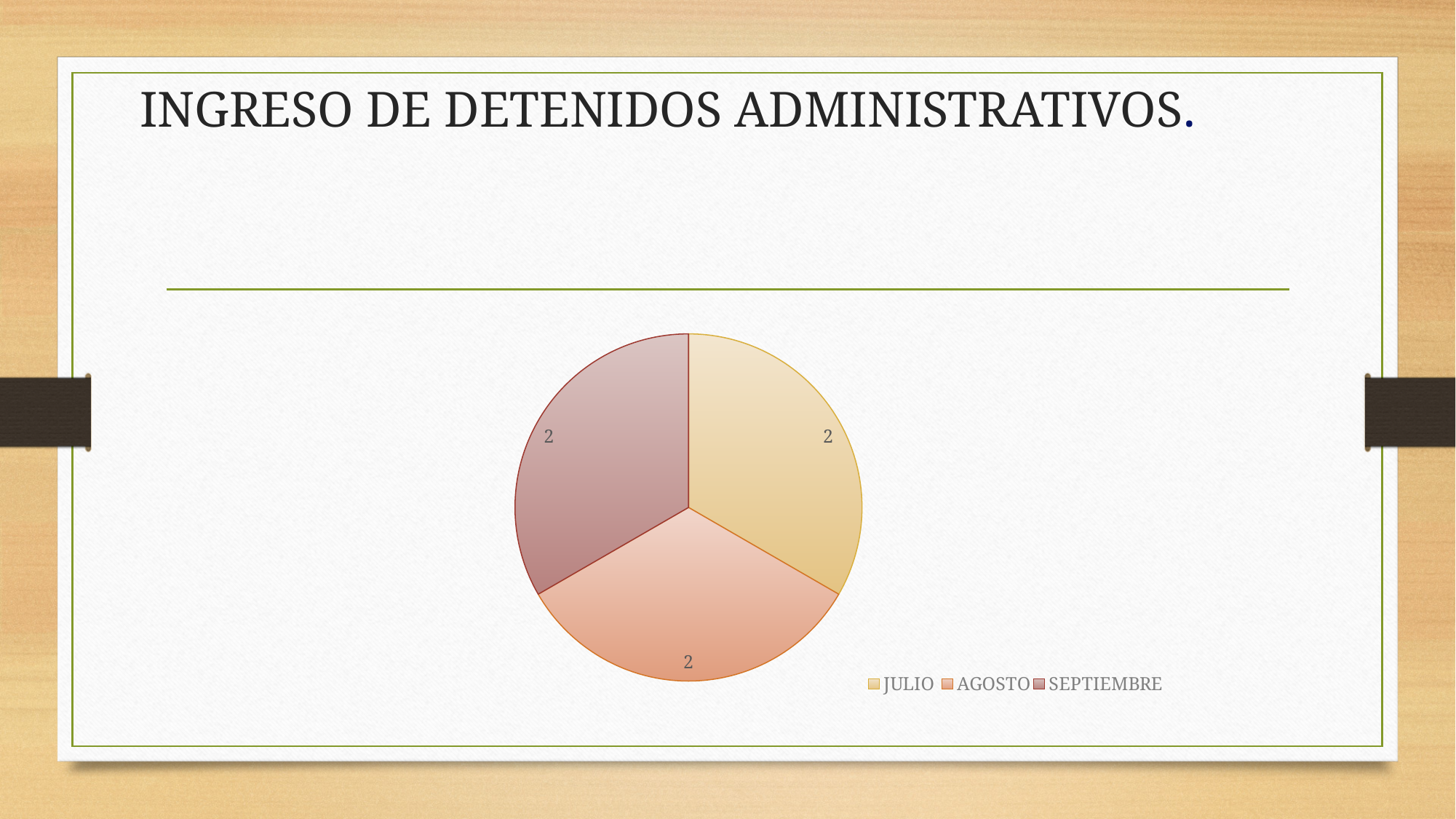
What is the title of the slide containing the pie chart? INGRESO DE DETENIDOS ADMINISTRATIVOS. What is the value for AGOSTO in the pie chart? 2 What is the value for SEPTIEMBRE in the pie chart? 2 Which legend entry is shown in the yellow colour in the pie chart? JULIO What is the difference between the values for JULIO and SEPTIEMBRE? 0 What is the total of all the slices in the pie chart? 6 How many slices does the pie chart have? 3 What is the value for JULIO in the pie chart? 2 How many entries does the legend of the pie chart list? 3 What kind of chart is shown on the slide? pie chart What share of the pie does the AGOSTO slice represent? one third